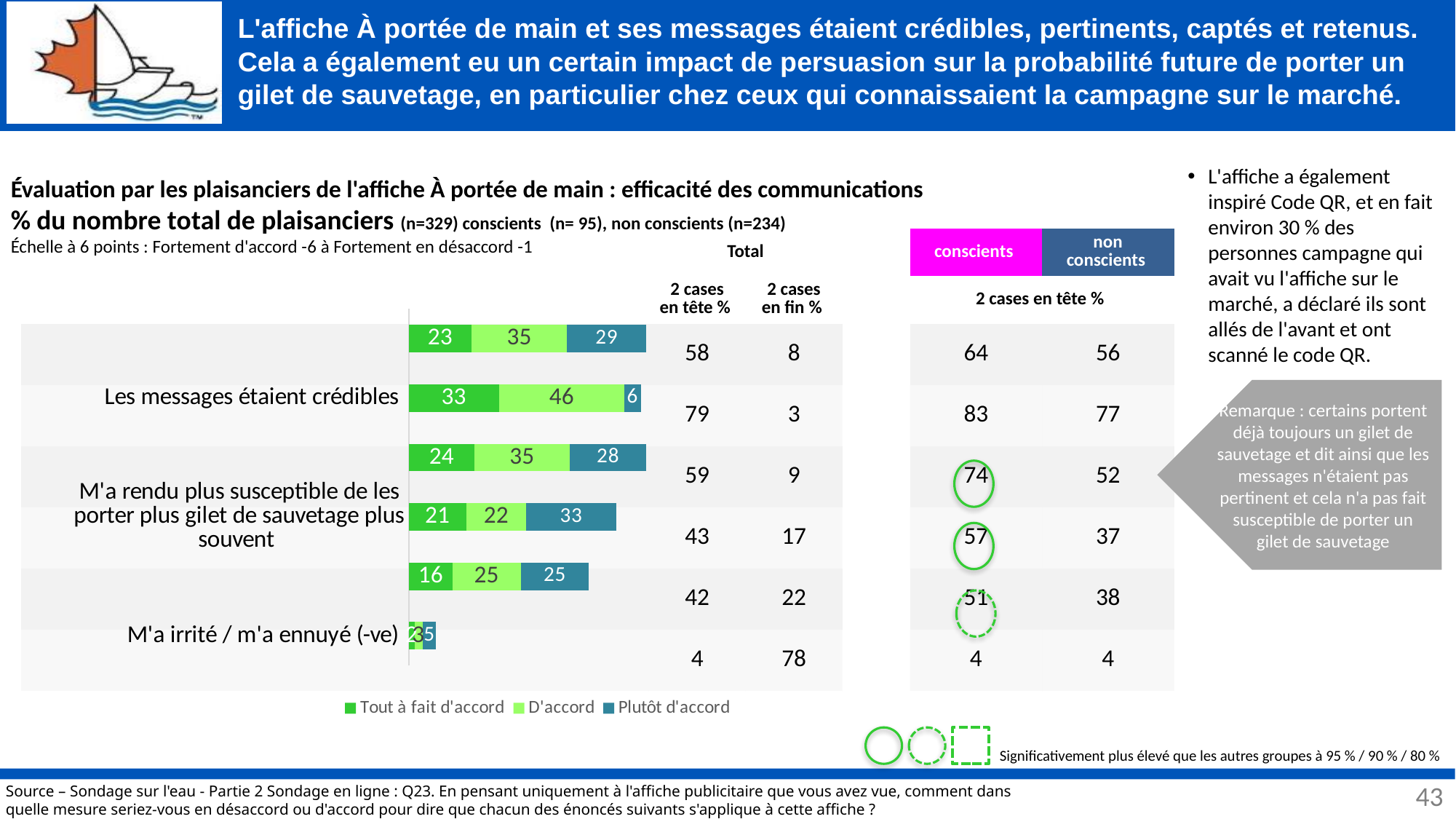
How many series does the legend of the bar chart list? 3 What kind of chart is used to show the boaters' evaluation of the poster? bar chart Which labelled category has the shortest stacked bar? M'a irrité / m'a ennuyé (-ve) Which colour represents 'Tout à fait d'accord' in the bar chart? dark green What are the three legend entries of the bar chart? Tout à fait d'accord, D'accord, Plutôt d'accord For 'Les messages étaient crédibles', which is larger: 'Tout à fait d'accord' or 'D'accord'? D'accord What is the 'D'accord' value for 'Les messages étaient crédibles'? 46 What is the 'Tout à fait d'accord' value for 'Les messages étaient crédibles'? 33 For 'Les messages étaient crédibles', what is the difference between the 'D'accord' and 'Tout à fait d'accord' values? 13 How many stacked bars are plotted in the chart? 6 What is the 'Plutôt d'accord' value for 'Les messages étaient crédibles'? 6 What is the total of the stacked bar for 'Les messages étaient crédibles'? 85